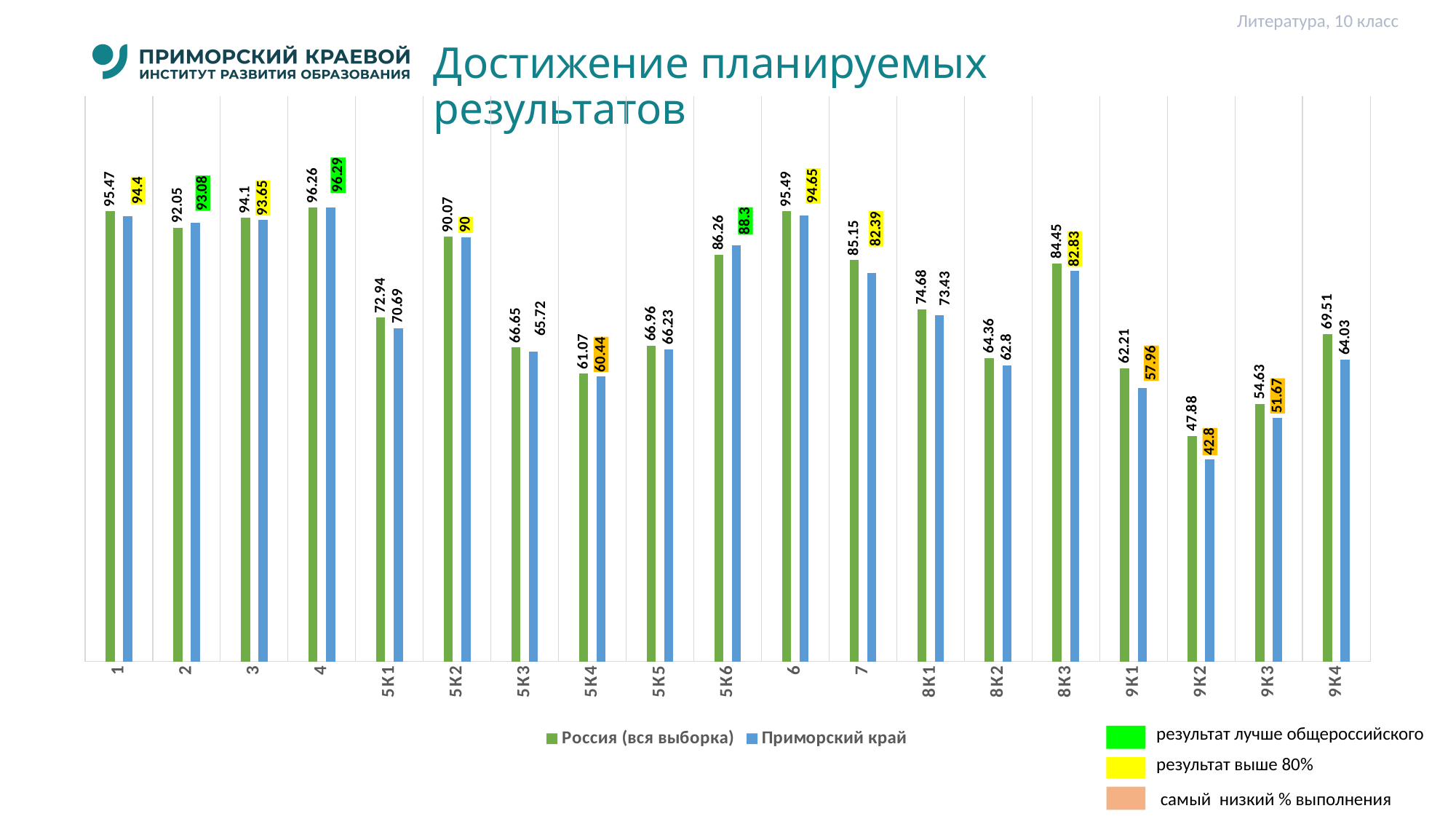
For category 5К6, which series has the larger value: Россия (вся выборка) or Приморский край? Приморский край Which category has the highest value for Приморский край? 4 According to the colour key, what does a yellow highlighted label mean? результат выше 80% How many series does the chart legend list? 2 For category 7, which series has the larger value: Россия (вся выборка) or Приморский край? Россия (вся выборка) What is the value for Приморский край for category 9К2? 42.8 What is the value for Приморский край for category 5К6? 88.3 What is the difference between the Россия (вся выборка) and Приморский край values for category 9К1? 4.25 Which category has the lowest value for Россия (вся выборка)? 9К2 What is the value for Россия (вся выборка) for category 5К1? 72.94 What type of chart is shown on the slide? bar chart How many categories are shown on the x axis of the chart? 19